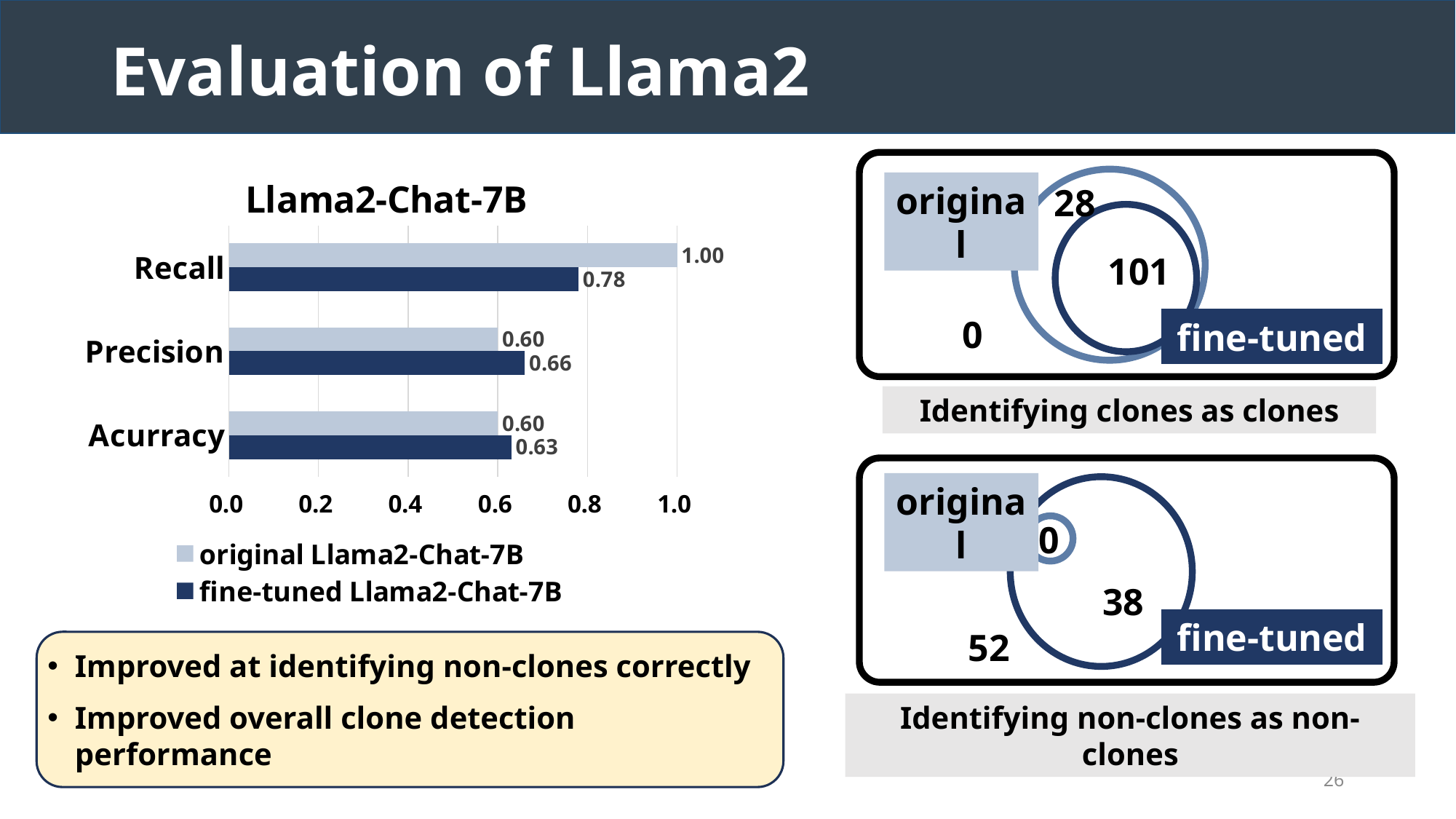
What is the Precision value for fine-tuned Llama2-Chat-7B? 0.66 Which metric has the lowest value for fine-tuned Llama2-Chat-7B? Acurracy Which is larger, the Precision of original Llama2-Chat-7B or the Precision of fine-tuned Llama2-Chat-7B? fine-tuned Llama2-Chat-7B What is the title of the bar chart? Llama2-Chat-7B What is the Acurracy value for original Llama2-Chat-7B? 0.60 How many metrics (categories) are shown in the bar chart? 3 Which metric has the highest value for fine-tuned Llama2-Chat-7B? Recall What kind of chart is used to show the Llama2-Chat-7B metrics? bar chart What is the Recall value for fine-tuned Llama2-Chat-7B? 0.78 What is the difference between the Recall values of original and fine-tuned Llama2-Chat-7B? 0.22 How many series does the legend of the bar chart list? 2 What is the Recall value for original Llama2-Chat-7B? 1.00